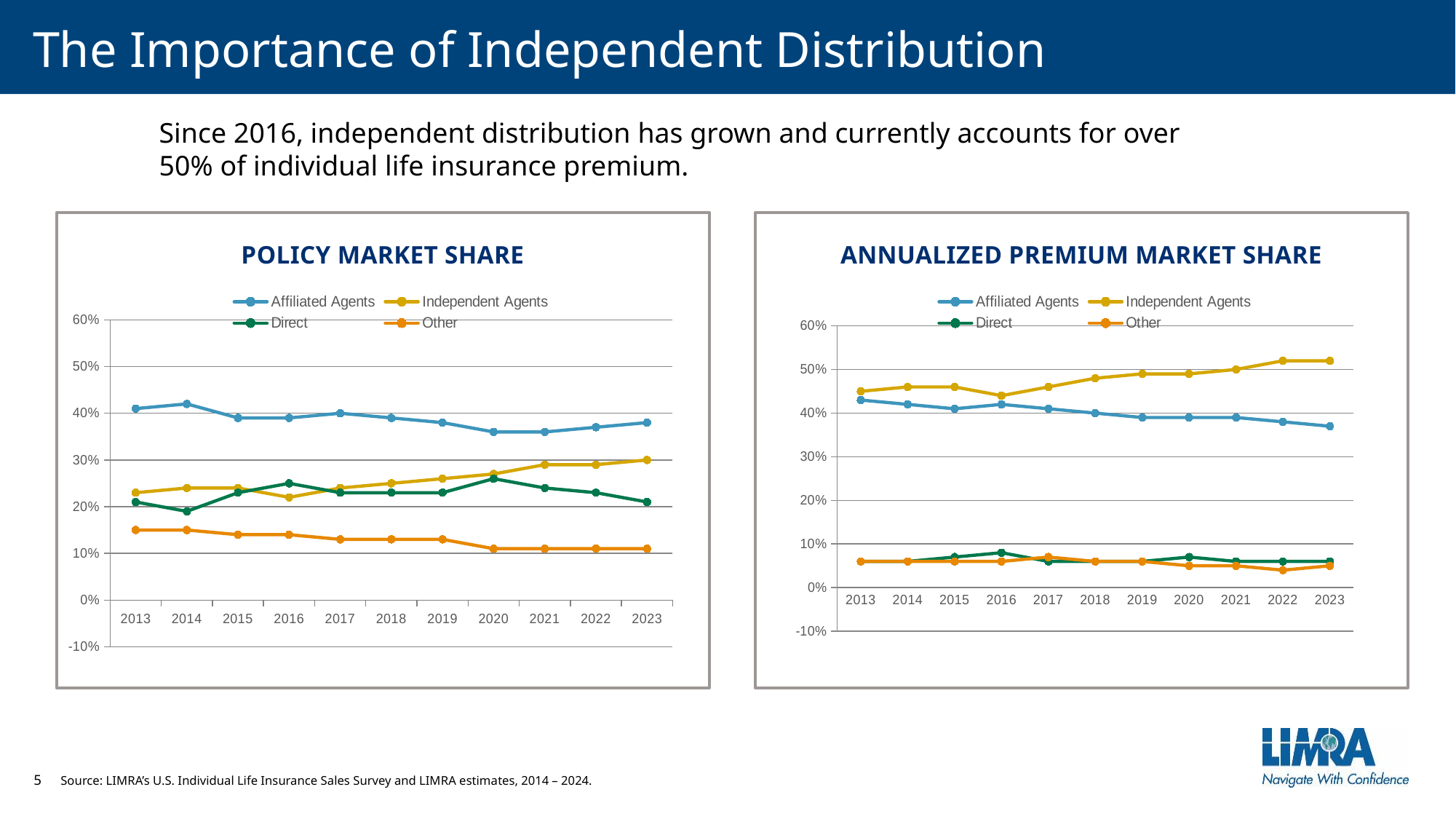
How many series does the legend of the Annualized Premium Market Share chart list? 4 How many years are shown on the x axis of the Policy Market Share chart? 11 In the Annualized Premium Market Share chart, which is larger in 2023: Independent Agents or Affiliated Agents? Independent Agents In the Annualized Premium Market Share chart, is the value for Independent Agents in 2023 greater or less than 50%? greater In the Policy Market Share chart, is the value for Affiliated Agents in 2014 greater or less than 40%? greater In the Policy Market Share chart, which is larger in 2023: Affiliated Agents or Independent Agents? Affiliated Agents What kind of chart is the Policy Market Share chart? line chart In the Policy Market Share chart, is the value for Other in 2023 greater or less than 20%? less What is the title of the chart on the right side of the slide? ANNUALIZED PREMIUM MARKET SHARE In the Annualized Premium Market Share chart, does the Independent Agents line generally rise or fall from 2016 to 2023? rise In the Policy Market Share chart, which series has the lowest value in 2023? Other